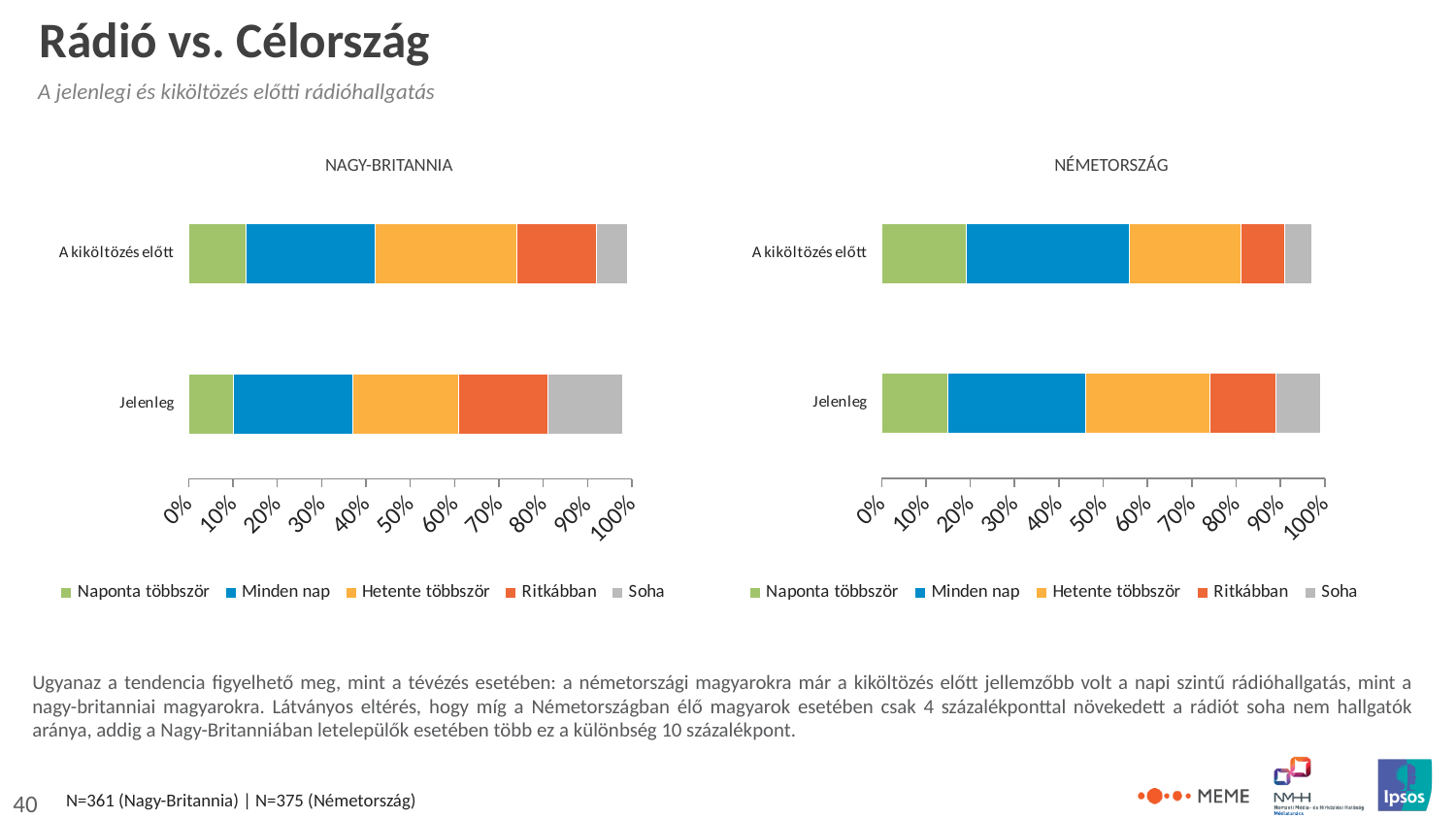
In the NAGY-BRITANNIA chart, which series has the largest segment in the A kiköltözés előtt bar? Hetente többször How many series does the legend of the NÉMETORSZÁG chart list? 5 In the NÉMETORSZÁG chart, is the Soha share for A kiköltözés előtt greater or less than 10%? less In the NÉMETORSZÁG chart, is the Minden nap segment larger for A kiköltözés előtt or for Jelenleg? A kiköltözés előtt In the NAGY-BRITANNIA chart, is the Naponta többször share for Jelenleg greater or less than 20%? less How many categories (bars) are shown in the NAGY-BRITANNIA chart? 2 In the NAGY-BRITANNIA chart, which series is shown in green? Naponta többször What are the two category labels on the NÉMETORSZÁG chart? A kiköltözés előtt, Jelenleg In the NÉMETORSZÁG chart, is the Minden nap share for A kiköltözés előtt greater or less than 30%? greater What kind of chart is the NAGY-BRITANNIA chart? Stacked bar chart In the NAGY-BRITANNIA chart, is the Soha segment larger for A kiköltözés előtt or for Jelenleg? Jelenleg